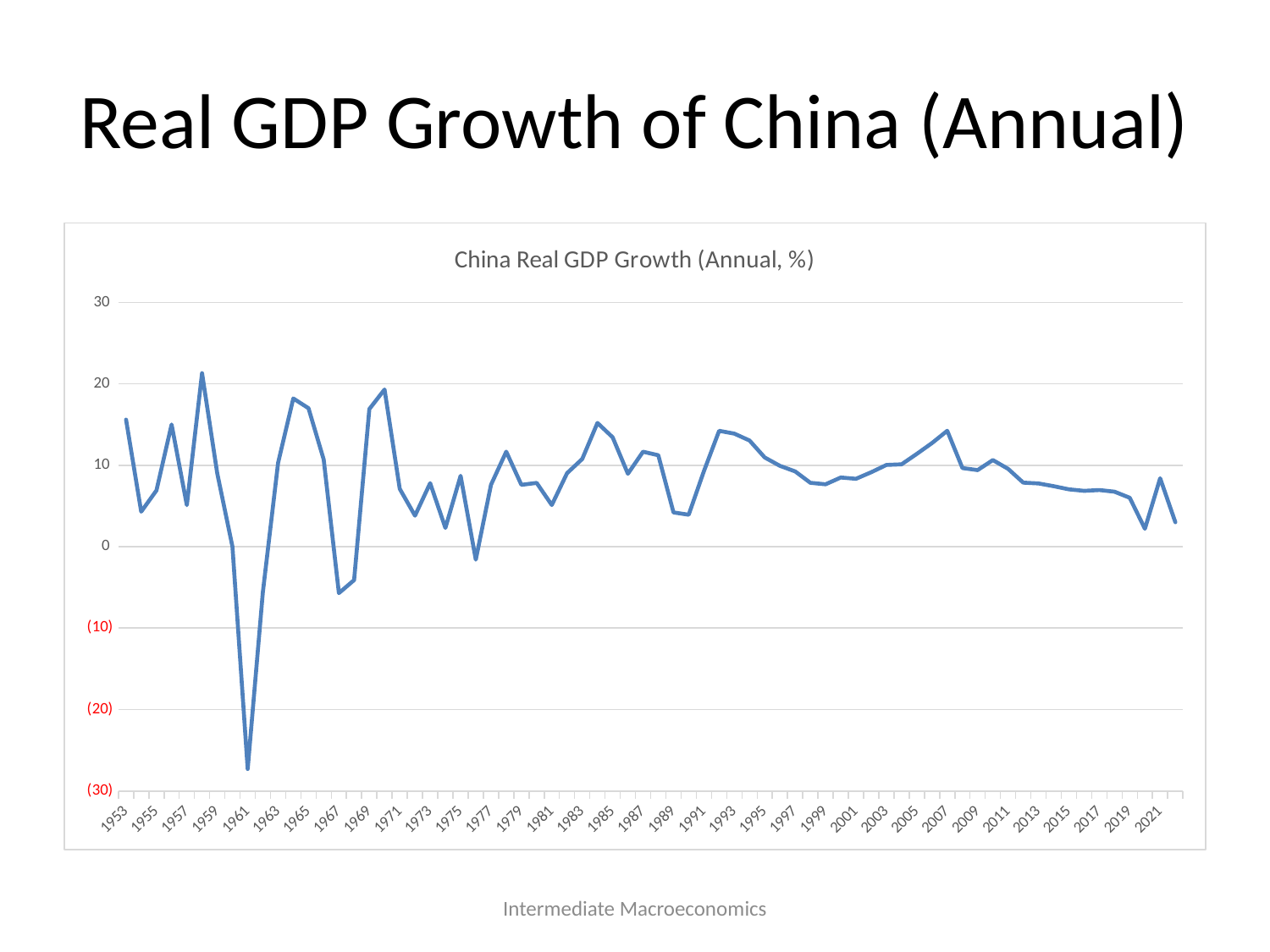
Is the value for 2020 greater or less than 10? less What is the title of the chart? China Real GDP Growth (Annual, %) What kind of chart is shown on the slide? line chart Is the value for 1967 greater or less than 0? less What colour is the line in the chart? blue Is the value for 1961 greater or less than (20)? less In which year does the line reach its lowest value? 1961 In which year does the line reach its highest value? 1958 Between 2007 and 2020, does the line generally rise or fall? fall Which year has the higher value, 1958 or 1990? 1958